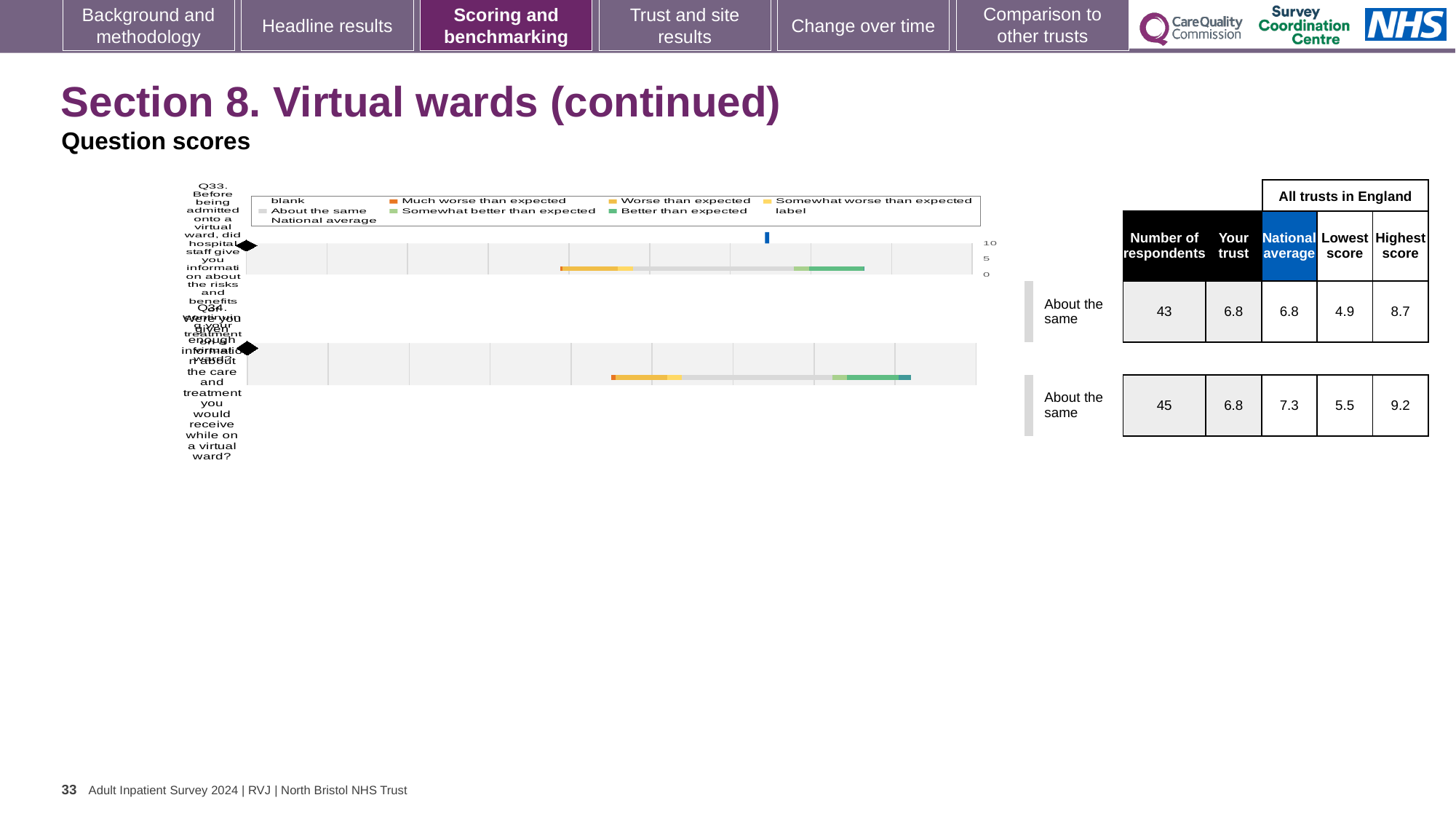
How many questions (Q33 and Q34) are plotted on the slide? 2 What is the highest tick value shown on the score axis of the charts? 10 What is the 'Your trust' score for Q33? 6.8 How many respondents answered Q33? 43 What benchmark category is shown for Q34 (Were you given enough information about the care and treatment you would receive while on a virtual ward)? About the same What is the national average score for Q34? 7.3 What is the difference between the highest score (8.7) and the lowest score (4.9) for Q33? 3.8 How many respondents answered Q34? 45 What benchmark category is shown for Q33 (Before being admitted onto a virtual ward, did hospital staff give you information about the risks and benefits)? About the same Which question has the higher national average score, Q33 or Q34? Q34 In the chart legend, what colour represents 'Much worse than expected'? orange What kind of chart is used to show the question scores for Q33 and Q34? bar chart